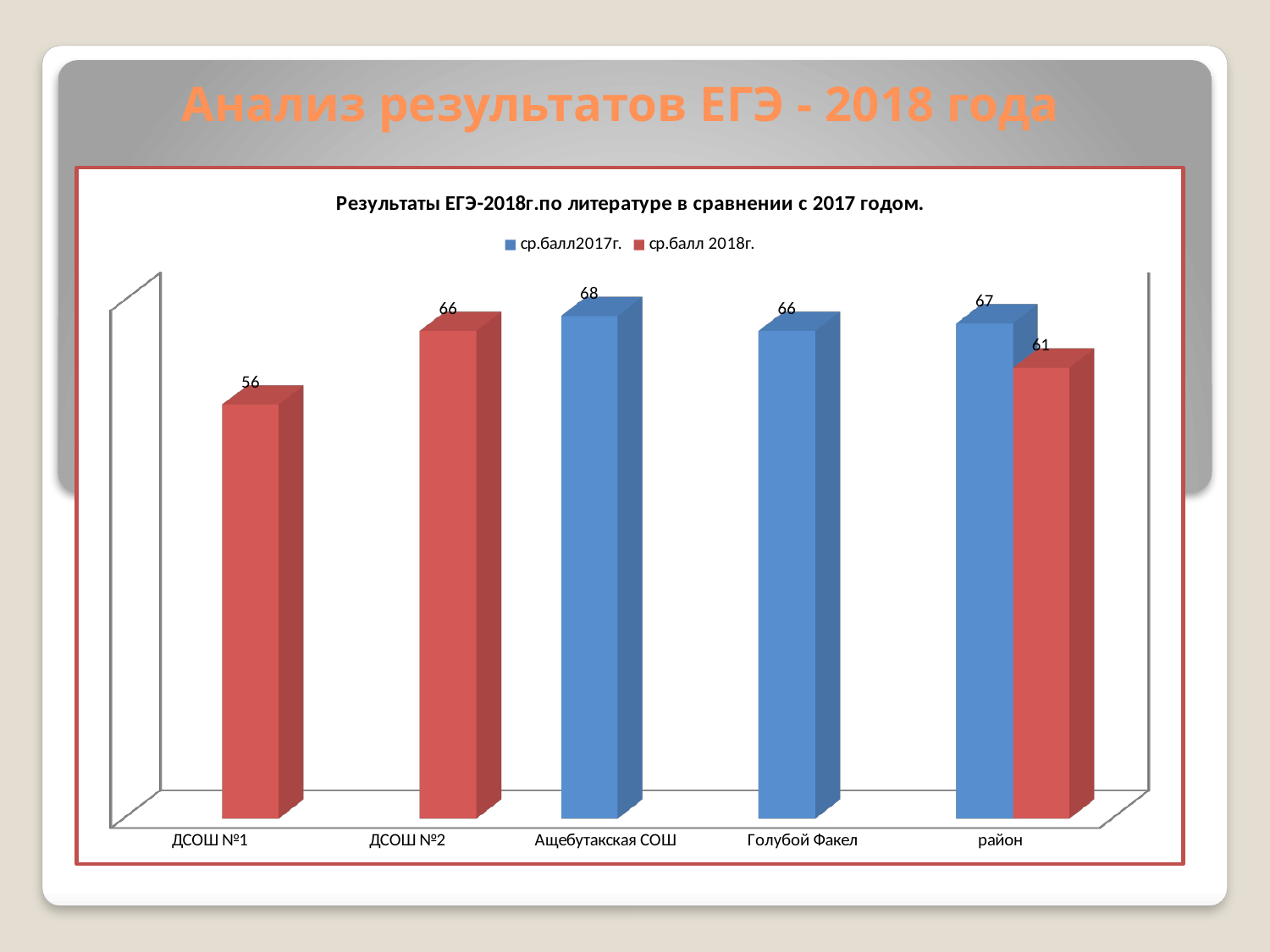
How many series does the legend list? 2 What is the difference between ср.балл2017г. and ср.балл 2018г. for район? 6 What is the value of ср.балл2017г. for Голубой Факел? 66 Which is larger for район: ср.балл2017г. or ср.балл 2018г.? ср.балл2017г. What kind of chart is shown on the slide? Bar chart What is the value of ср.балл 2018г. for ДСОШ №2? 66 Which category has the highest value for ср.балл2017г.? Ащебутакская СОШ What is the value of ср.балл2017г. for Ащебутакская СОШ? 68 Which category has the lowest value for ср.балл 2018г.? ДСОШ №1 How many categories are shown on the x axis? 5 What is the value of ср.балл 2018г. for район? 61 What is the value of ср.балл 2018г. for ДСОШ №1? 56